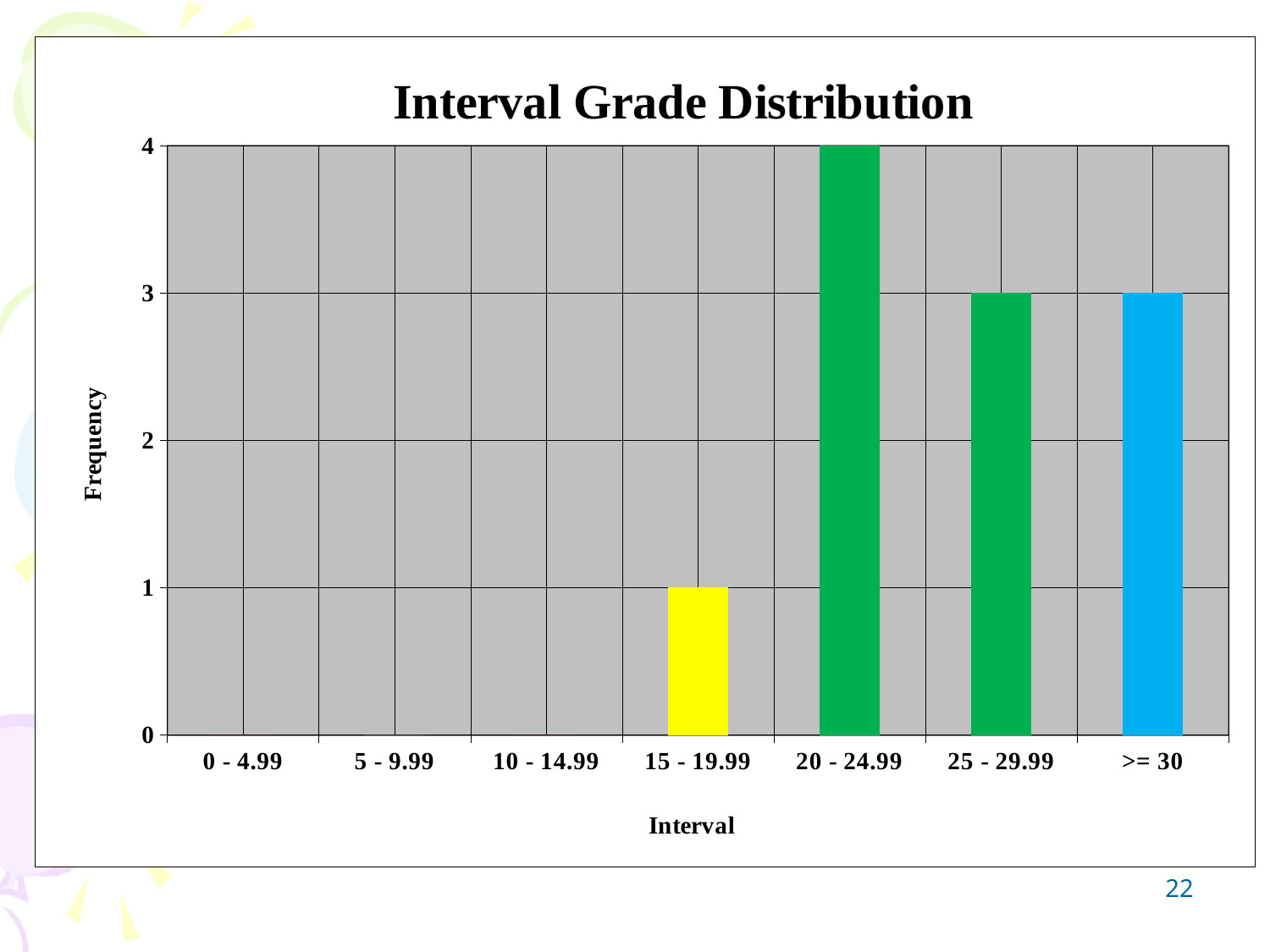
How many intervals are shown on the x axis? 7 What type of chart is shown on the slide? bar chart What is the frequency for the >= 30 interval? 3 What is the frequency for the 20 - 24.99 interval? 4 Which has a higher frequency, the 20 - 24.99 interval or the 25 - 29.99 interval? 20 - 24.99 What is the difference in frequency between the 20 - 24.99 interval and the 15 - 19.99 interval? 3 What is the frequency for the 15 - 19.99 interval? 1 What is the title of the chart? Interval Grade Distribution Which interval has the highest frequency? 20 - 24.99 What is the frequency for the 25 - 29.99 interval? 3 What is the label of the y axis? Frequency What is the frequency for the 0 - 4.99 interval? 0